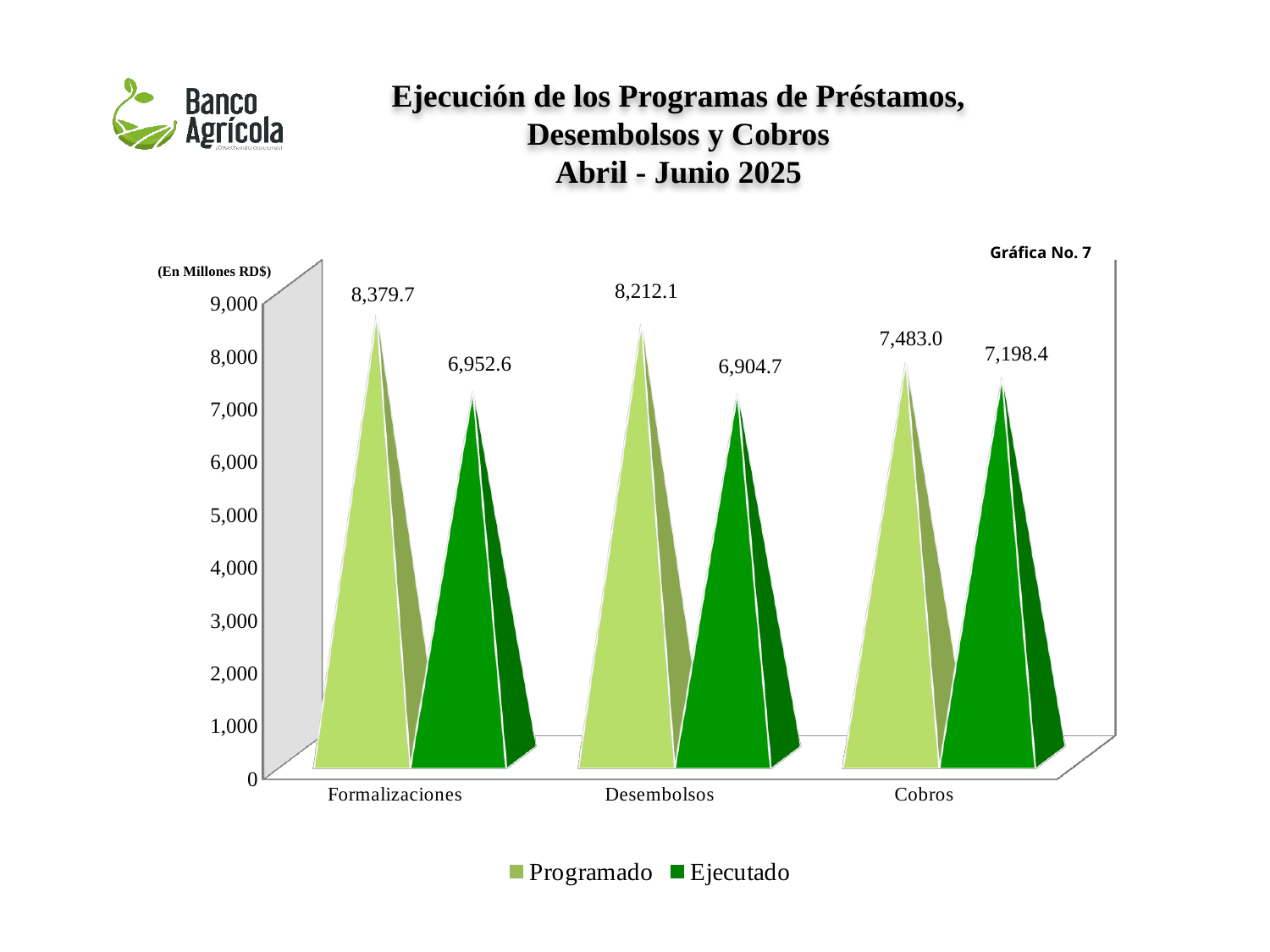
What is the Programado value for Cobros? 7,483.0 What is the Programado value for Formalizaciones? 8,379.7 Which category has the lowest Ejecutado value? Desembolsos What is the Ejecutado value for Cobros? 7,198.4 What is the difference between the Programado and Ejecutado values for Cobros? 284.6 How many series does the legend list? 2 What is the difference between the Programado and Ejecutado values for Formalizaciones? 1,427.1 Which is larger, the Ejecutado value for Cobros or the Ejecutado value for Formalizaciones? Cobros What is the Ejecutado value for Desembolsos? 6,904.7 How many categories are shown on the x axis? 3 Which category has the highest Programado value? Formalizaciones What kind of chart is shown on the slide? Bar chart